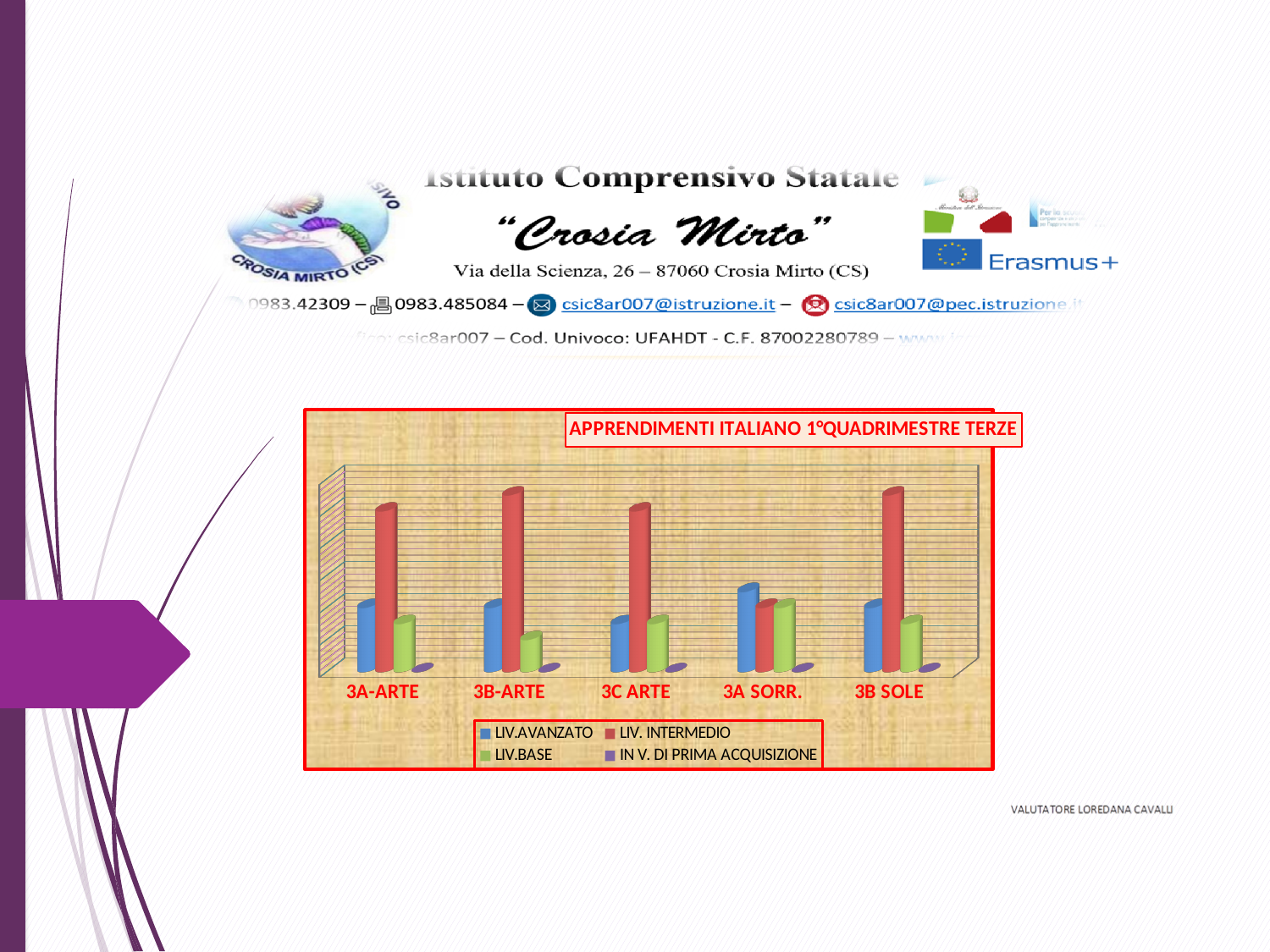
Which class has the highest LIV.AVANZATO bar? 3A SORR. Which class has the lowest LIV.BASE bar? 3B-ARTE How many classes (categories) are shown on the x axis of the chart? 5 Which class has the lowest LIV. INTERMEDIO bar? 3A SORR. Which series has the tallest bar for 3A SORR.? LIV.AVANZATO What is the title of the chart? APPRENDIMENTI ITALIANO 1°QUADRIMESTRE TERZE What kind of chart is shown on the slide? bar chart Which series has the lowest bar for 3B SOLE? IN V. DI PRIMA ACQUISIZIONE Which series has the tallest bar for 3A-ARTE? LIV. INTERMEDIO For 3B-ARTE, which is larger: LIV.AVANZATO or LIV.BASE? LIV.AVANZATO Which colour represents LIV. INTERMEDIO in the chart? red How many series does the chart legend list? 4